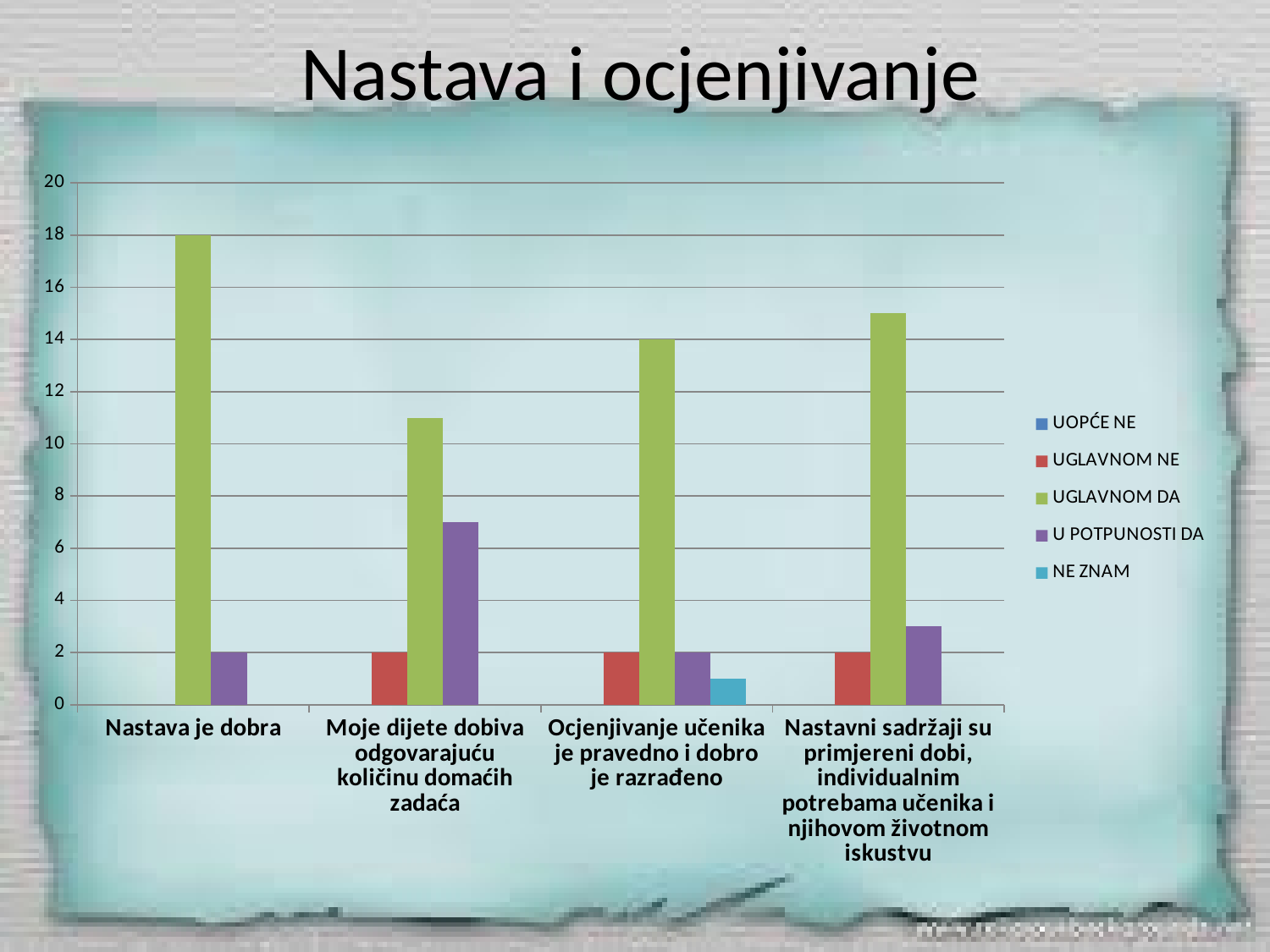
Which statement has the highest UGLAVNOM DA value? Nastava je dobra What is the value of UGLAVNOM DA for "Ocjenjivanje učenika je pravedno i dobro je razrađeno"? 14 Is the NE ZNAM value for "Ocjenjivanje učenika je pravedno i dobro je razrađeno" greater or less than 2? less What is the title of the slide? Nastava i ocjenjivanje What is the value of U POTPUNOSTI DA for "Nastava je dobra"? 2 Which statement has the lowest UGLAVNOM DA value? Moje dijete dobiva odgovarajuću količinu domaćih zadaća Is the UGLAVNOM DA value for "Moje dijete dobiva odgovarajuću količinu domaćih zadaća" greater or less than 10? greater How many series does the legend list? 5 What kind of chart is shown on the slide? bar chart How many categories (statements) are shown along the x axis? 4 What is the value of UGLAVNOM DA for "Nastava je dobra"? 18 What is the difference between the UGLAVNOM DA values for "Nastava je dobra" and "Ocjenjivanje učenika je pravedno i dobro je razrađeno"? 4